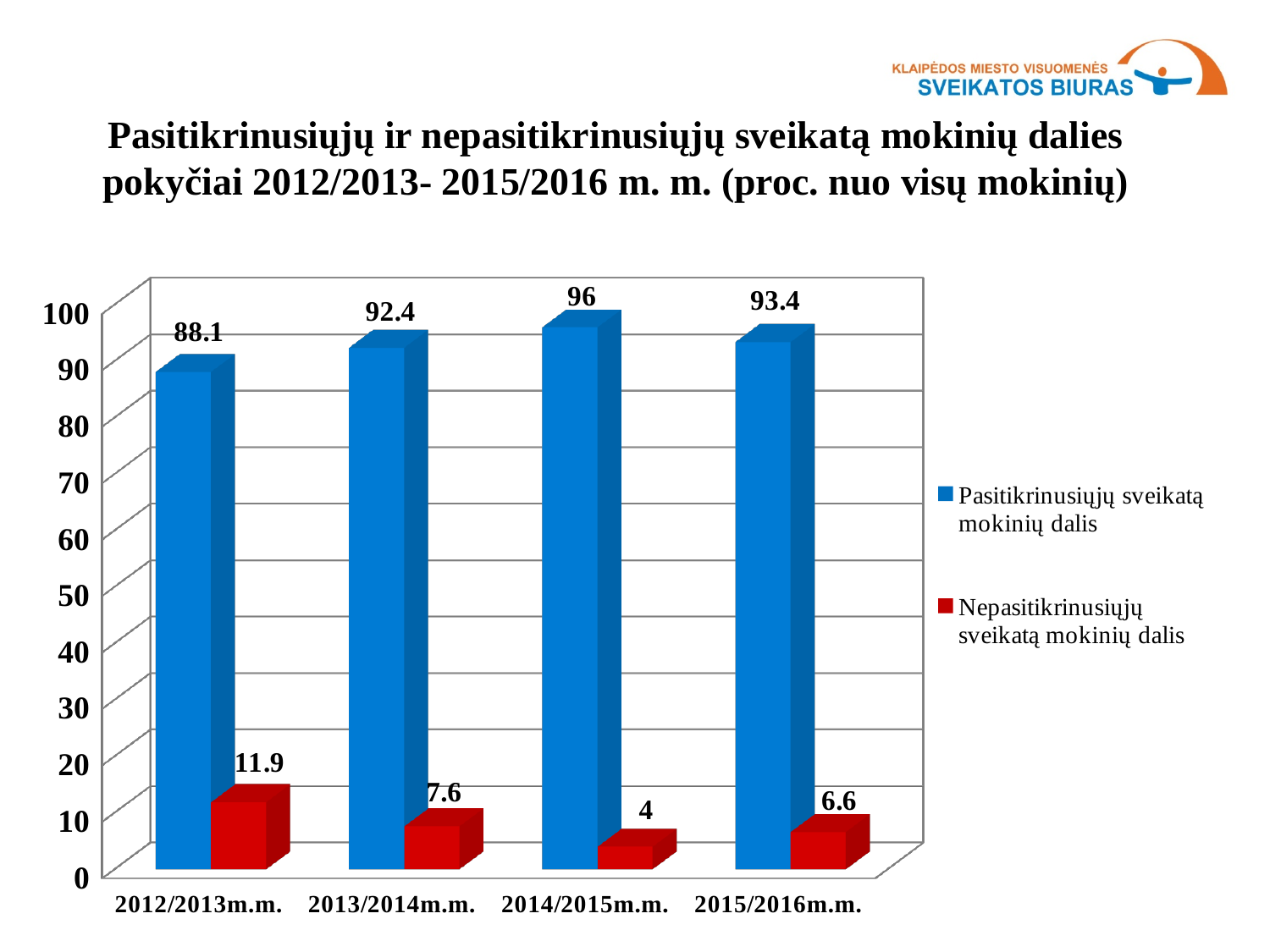
What is the difference between the Pasitikrinusiųjų sveikatą mokinių dalis values for 2013/2014m.m. and 2012/2013m.m.? 4.3 What colour are the bars for Nepasitikrinusiųjų sveikatą mokinių dalis? Red What is the value for Pasitikrinusiųjų sveikatą mokinių dalis in 2015/2016m.m.? 93.4 What kind of chart is shown on the slide? Bar chart Which is larger: the Nepasitikrinusiųjų sveikatą mokinių dalis value for 2013/2014m.m. or for 2015/2016m.m.? 2013/2014m.m. Does the Nepasitikrinusiųjų sveikatą mokinių dalis value rise or fall from 2012/2013m.m. to 2014/2015m.m.? Fall In which school year is the Pasitikrinusiųjų sveikatą mokinių dalis value highest? 2014/2015m.m. How many school years are shown on the x axis? 4 In which school year is the Nepasitikrinusiųjų sveikatą mokinių dalis value lowest? 2014/2015m.m. What is the value for Nepasitikrinusiųjų sveikatą mokinių dalis in 2012/2013m.m.? 11.9 How many series does the legend list? 2 What is the value for Pasitikrinusiųjų sveikatą mokinių dalis in 2014/2015m.m.? 96